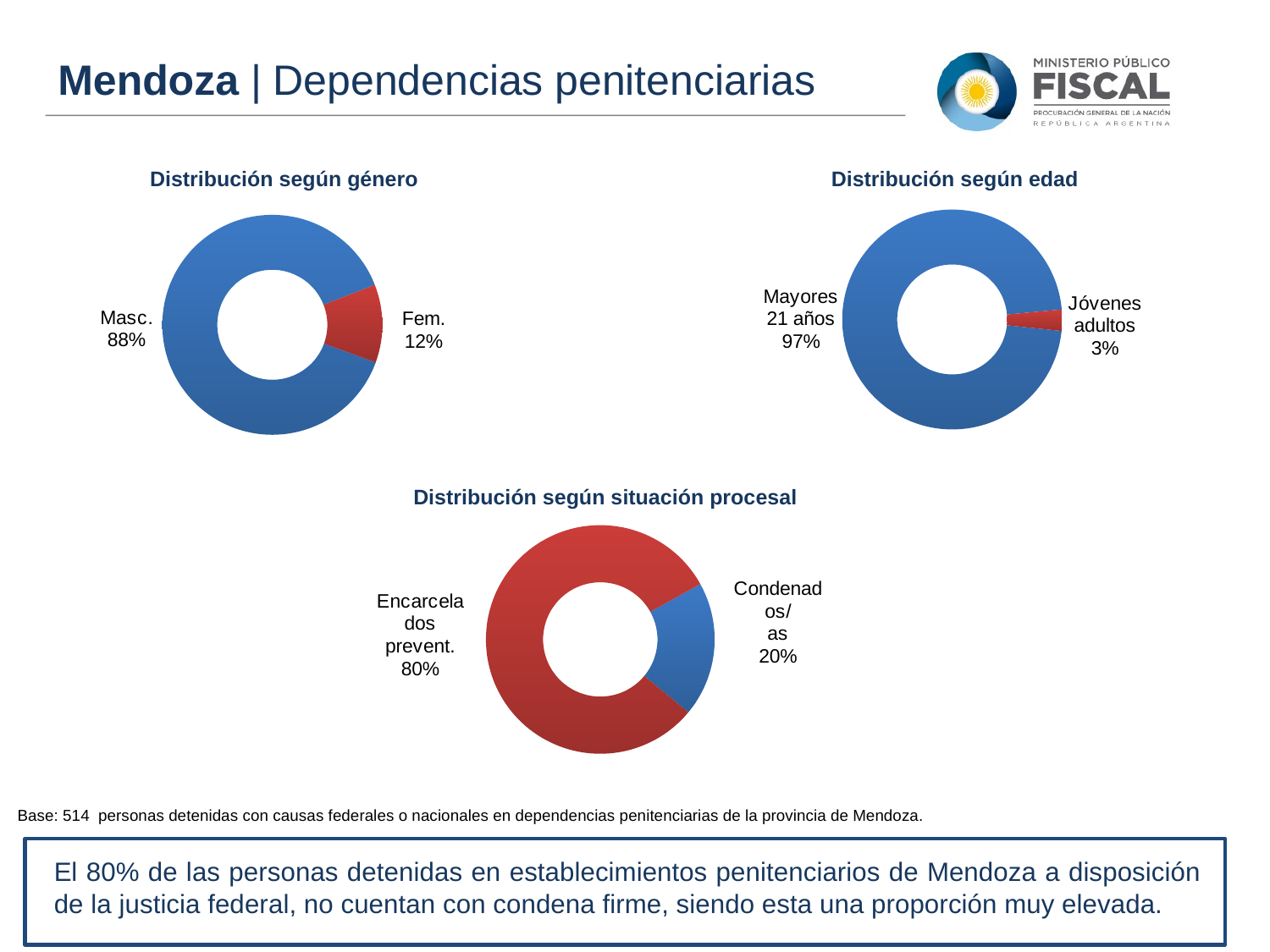
In the 'Distribución según situación procesal' chart, what share is labelled for Condenados/as? 20% In the 'Distribución según situación procesal' chart, what share is labelled for Encarcelados prevent.? 80% In the 'Distribución según género' chart, which category has the largest share? Masc. In the 'Distribución según género' chart, what share is labelled for Masc.? 88% In the 'Distribución según género' chart, what share is labelled for Fem.? 12% How many charts are shown on the slide? 3 In the 'Distribución según edad' chart, which category has the smallest share? Jóvenes adultos In the 'Distribución según situación procesal' chart, what is the difference in percentage points between Encarcelados prevent. and Condenados/as? 60 In the 'Distribución según edad' chart, what share is labelled for Jóvenes adultos? 3% In the 'Distribución según género' chart, how many categories are shown? 2 What kind of chart is 'Distribución según situación procesal'? Pie chart (doughnut) In the 'Distribución según edad' chart, what share is labelled for Mayores 21 años? 97%